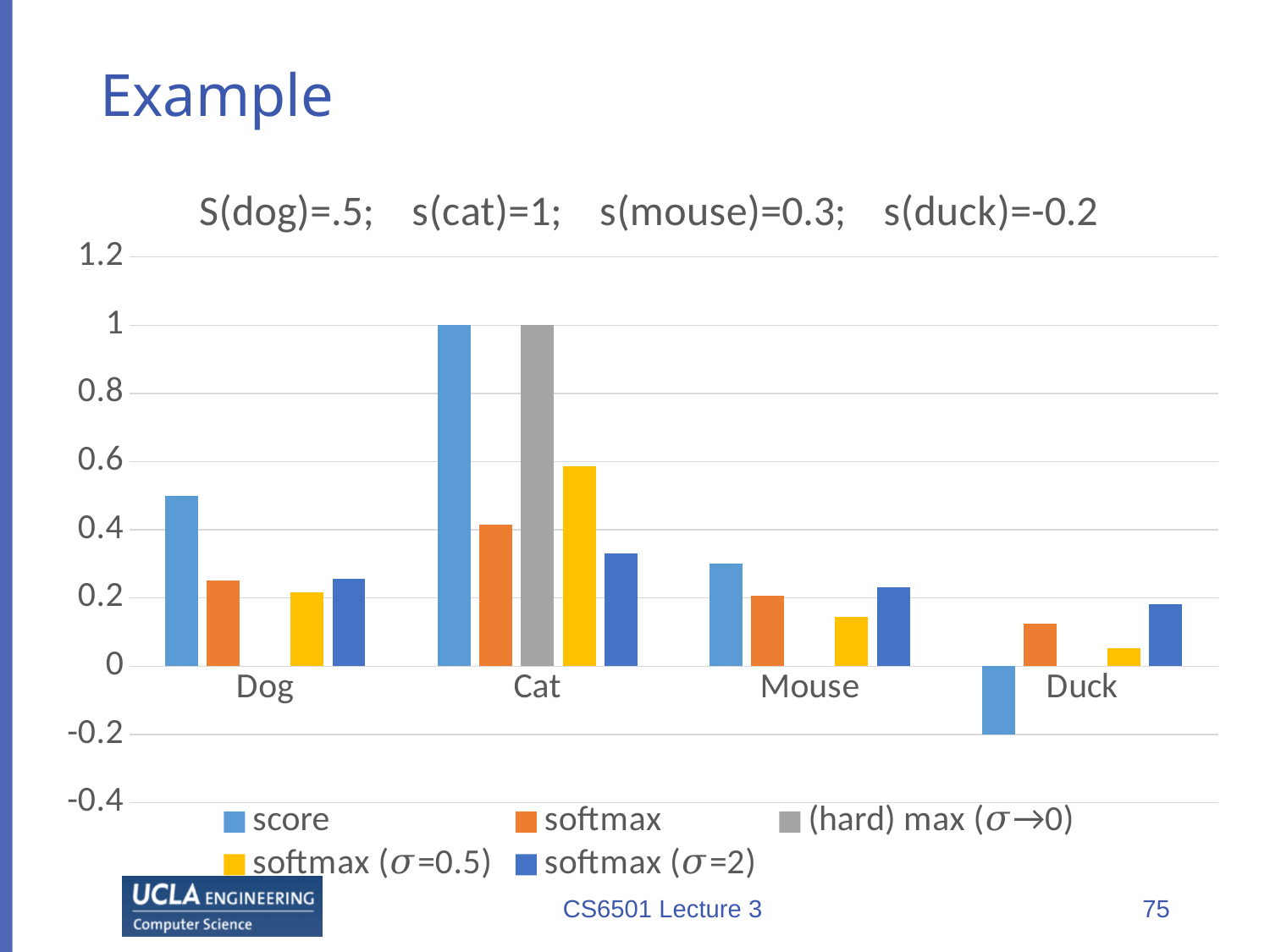
How many categories are shown on the x axis of the chart? 4 Which legend entry is shown in gray? (hard) max (σ→0) How many series does the chart's legend list? 5 Which category has the highest score value? Cat Which category has the lowest score value? Duck What kind of chart is shown on the slide? bar chart Is the softmax value for Dog greater or less than 0.4? less For Cat, which is larger: the score value or the softmax value? score What is the score value for Cat? 1 What is the difference between the score value for Cat and the score value for Dog? 0.5 Is the softmax (σ=0.5) value for Cat greater or less than 0.4? greater What is the score value for Duck? -0.2